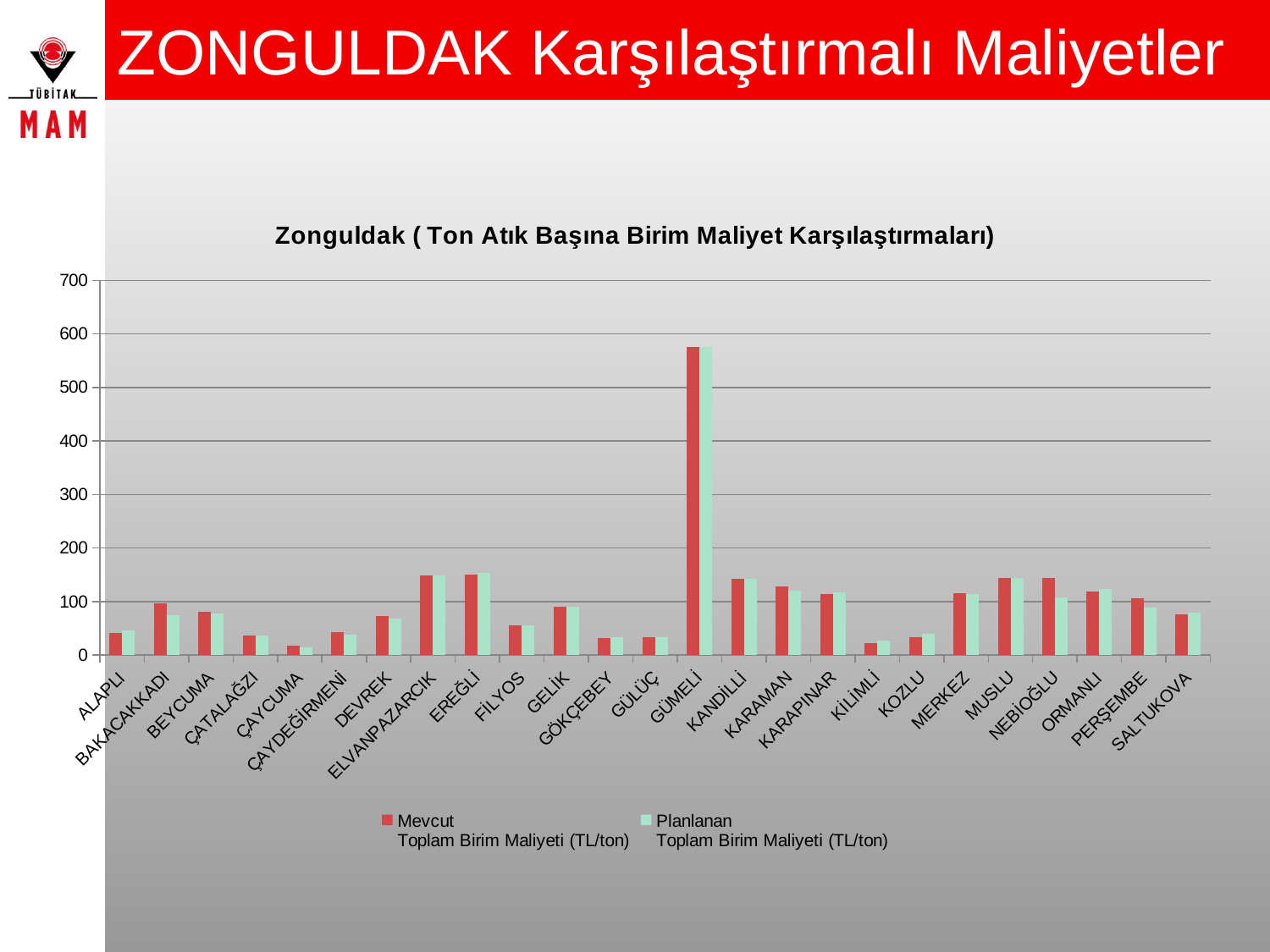
Is the Mevcut value for GÜMELİ greater or less than 500? greater How many categories are shown on the x axis? 25 Is the Mevcut value for MUSLU greater or less than 100? greater Which has a larger Mevcut value, EREĞLİ or GÖKÇEBEY? EREĞLİ How many series does the legend list? 2 Which category has the lowest Mevcut Toplam Birim Maliyeti? ÇAYCUMA Which is larger for NEBİOĞLU, the Mevcut value or the Planlanan value? Mevcut Which category has the highest Mevcut Toplam Birim Maliyeti? GÜMELİ Is the Planlanan value for FİLYOS greater or less than 100? less What is the title of the chart? Zonguldak ( Ton Atık Başına Birim Maliyet Karşılaştırmaları) What kind of chart is shown on the slide? bar chart